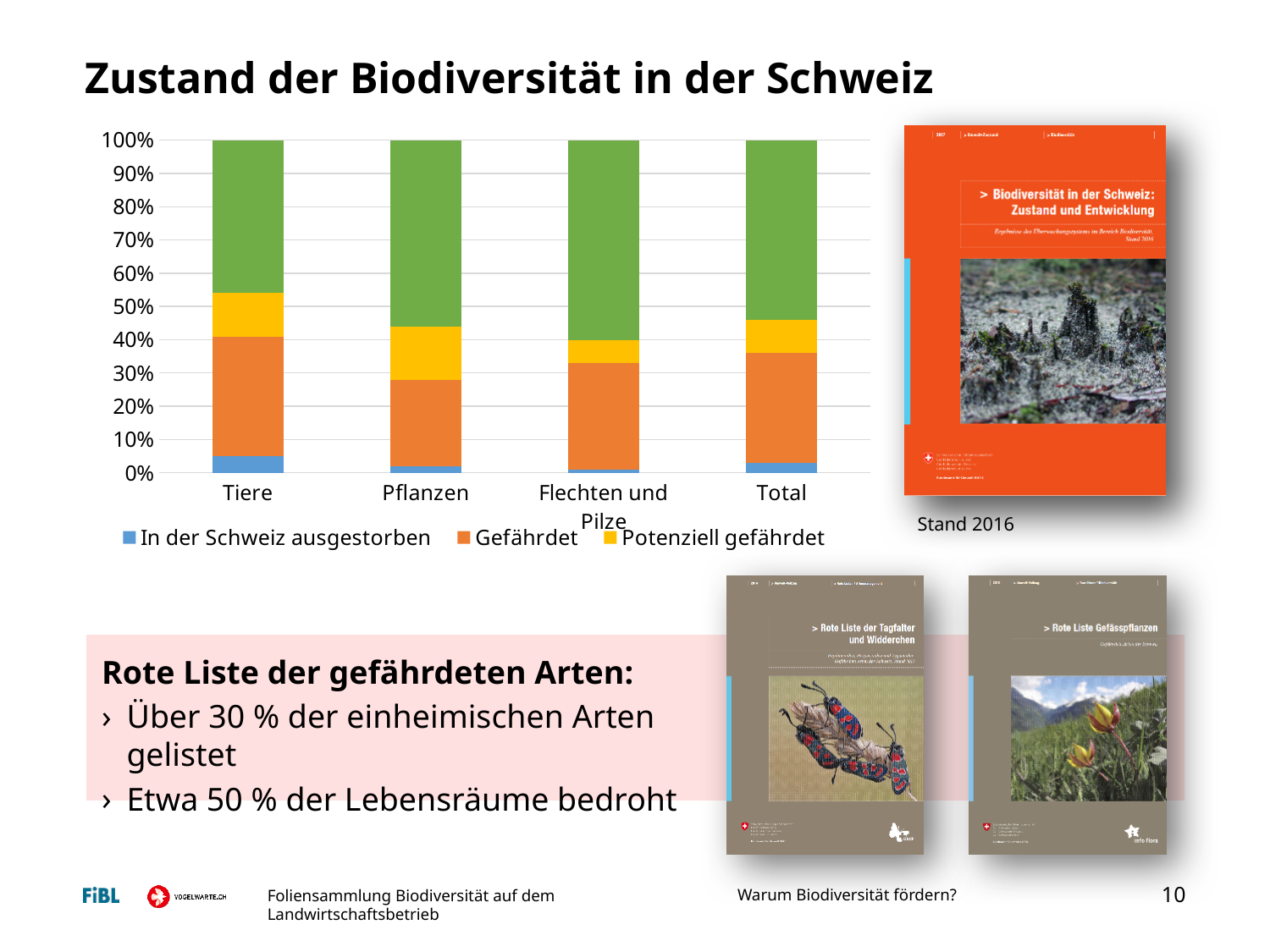
What kind of chart is shown on the slide? stacked bar chart Is the combined share of the three legend series (ausgestorben, gefährdet, potenziell gefährdet) for Pflanzen greater or less than 50%? less Is the 'In der Schweiz ausgestorben' segment for Tiere greater or less than 10%? less What is the title of the slide containing the chart? Zustand der Biodiversität in der Schweiz Which category has a larger 'Gefährdet' segment, Tiere or Pflanzen? Tiere Which colour represents the series 'Gefährdet' in the chart? orange Is the combined share of the three legend series (ausgestorben, gefährdet, potenziell gefährdet) for Tiere greater or less than 50%? greater How many series does the chart's legend list? 3 How many categories are shown on the x axis of the chart? 4 Which category has the largest 'In der Schweiz ausgestorben' segment? Tiere Which category has a larger combined share of the three legend series, Tiere or Pflanzen? Tiere